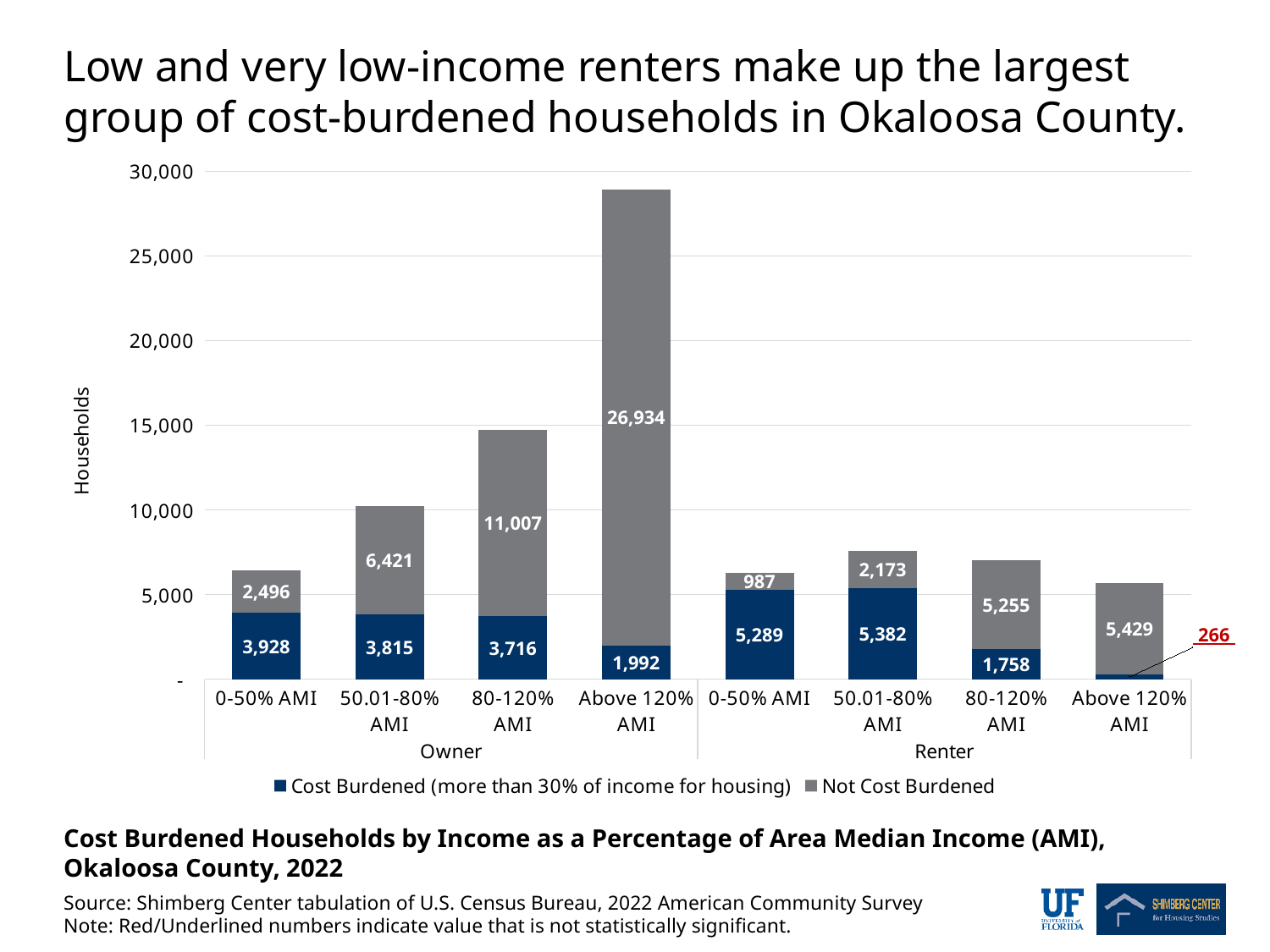
What is the total number of households for renters at 0-50% AMI? 6,276 Which is larger: the number of cost-burdened renters at 0-50% AMI or the number of cost-burdened owners at 0-50% AMI? Cost-burdened renters at 0-50% AMI How many cost-burdened households are there among renters above 120% AMI? 266 What is the difference between the cost-burdened households for owners at 0-50% AMI and owners at 80-120% AMI? 212 Is the total height of the bar for owners at 80-120% AMI greater or less than 10,000? greater How many not-cost-burdened households are there among owners above 120% AMI? 26,934 How many series does the legend list? 2 What is the total number of households for owners above 120% AMI? 28,926 Which income group has the lowest number of cost-burdened households? Renter Above 120% AMI What kind of chart is shown on the slide? Stacked bar chart How many cost-burdened households are there among renters at 50.01-80% AMI? 5,382 Which income group has the highest number of cost-burdened households? Renter 50.01-80% AMI